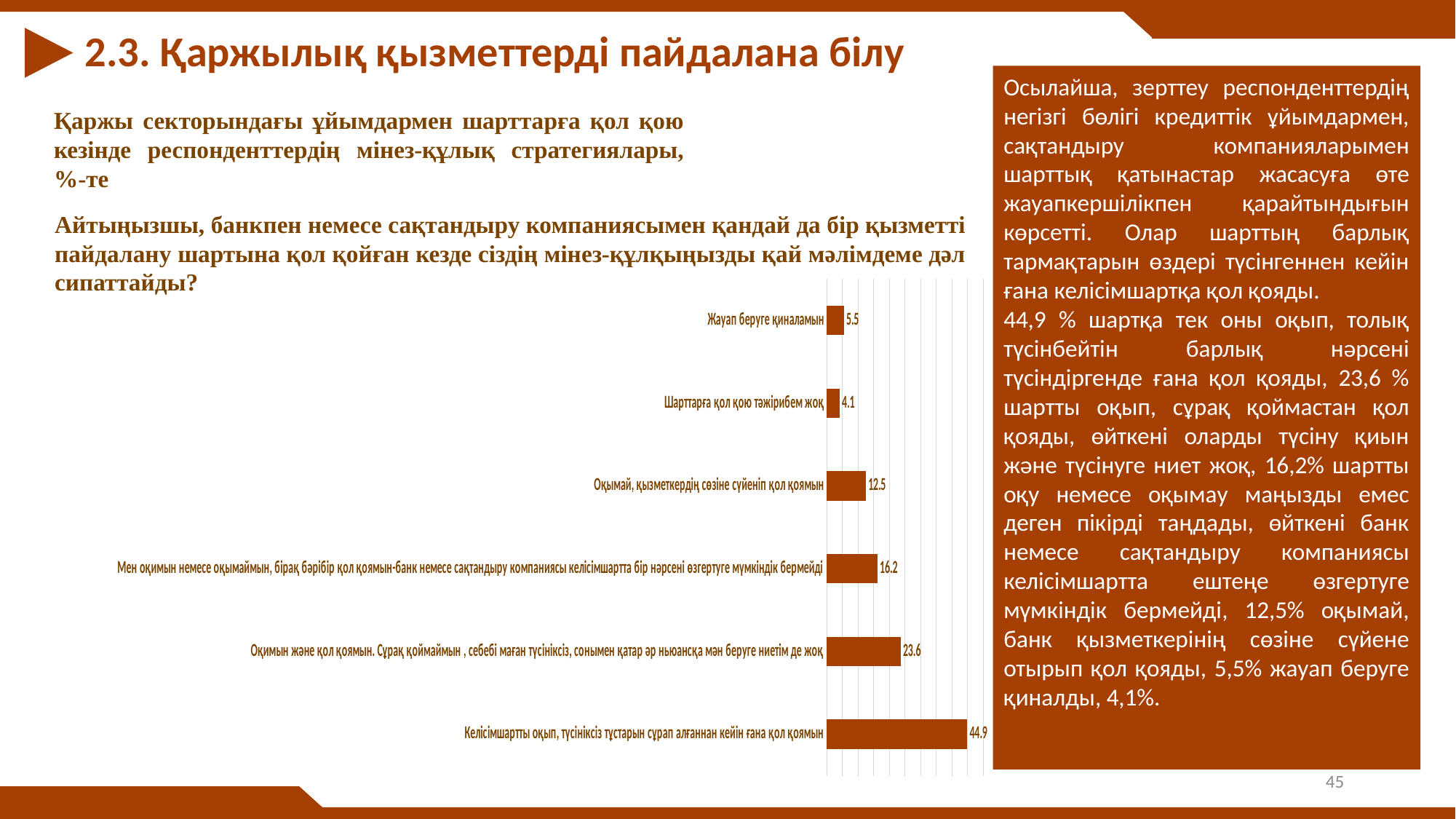
What value is shown for the category "Шарттарға қол қою тәжірибем жоқ"? 4.1 How many categories are plotted in the chart? 6 Which is larger: the value for "Оқымай, қызметкердің сөзіне сүйеніп қол қоямын" or the value for "Жауап беруге қиналамын"? Оқымай, қызметкердің сөзіне сүйеніп қол қоямын Which category has the highest value in the chart? Келісімшартты оқып, түсініксіз тұстарын сұрап алғаннан кейін ғана қол қоямын What is the difference between the highest value (44.9) and the lowest value (4.1) in the chart? 40.8 What value is shown for the category "Жауап беруге қиналамын"? 5.5 What value is shown for the category "Оқымай, қызметкердің сөзіне сүйеніп қол қоямын"? 12.5 Which category has the lowest value in the chart? Шарттарға қол қою тәжірибем жоқ What value is shown for the category "Келісімшартты оқып, түсініксіз тұстарын сұрап алғаннан кейін ғана қол қоямын"? 44.9 What kind of chart is shown on the slide? Bar chart What is the difference between the values for "Оқимын және қол қоямын. Сұрақ қоймаймын..." (23.6) and "Мен оқимын немесе оқымаймын, бірақ бәрібір қол қоямын..." (16.2)? 7.4 What colour are the bars in the chart? Brown